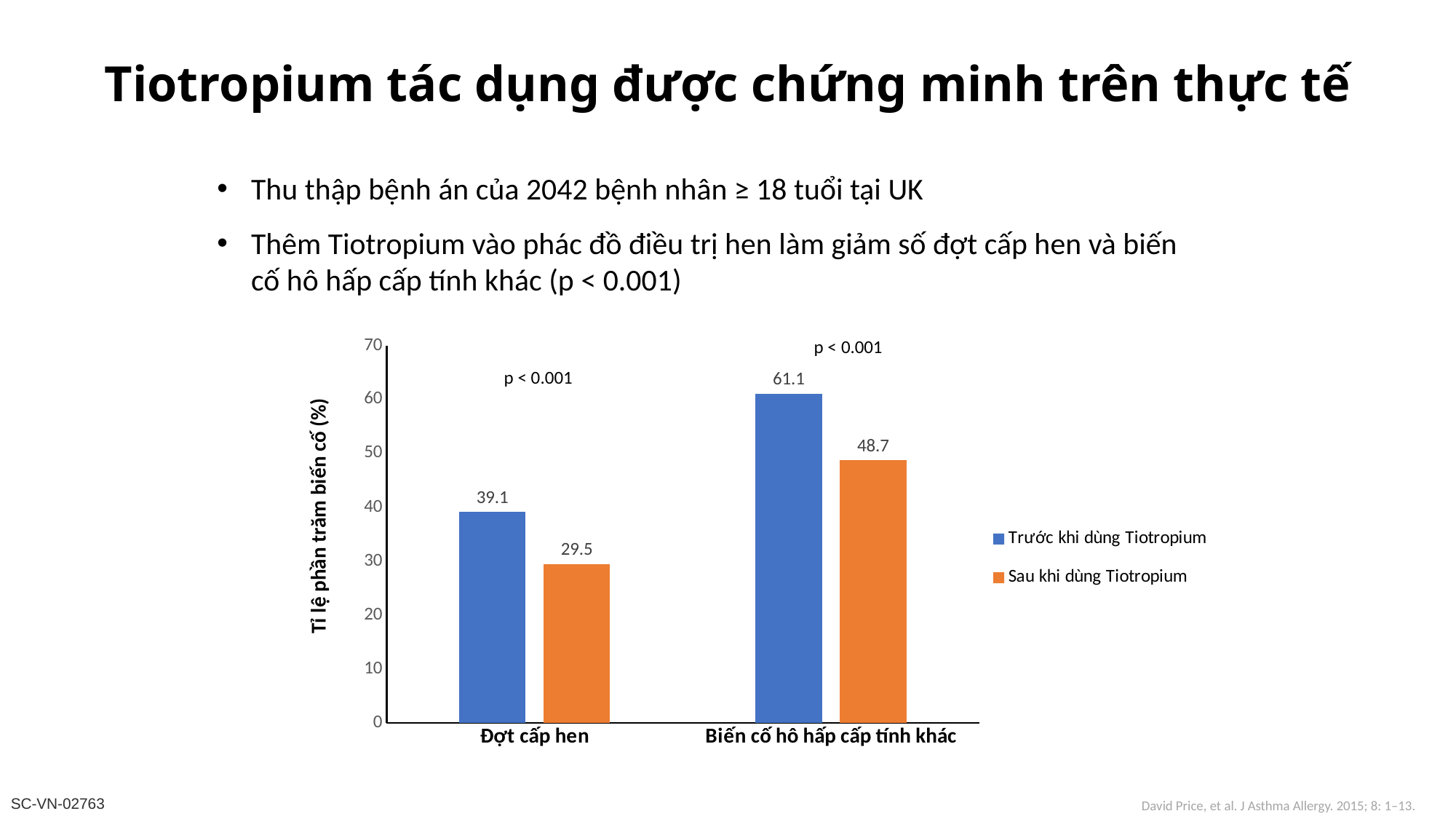
What is the value for 'Trước khi dùng Tiotropium' in the 'Đợt cấp hen' category? 39.1 How many series does the chart legend list? 2 What is the difference between the 'Trước khi dùng Tiotropium' and 'Sau khi dùng Tiotropium' values for 'Biến cố hô hấp cấp tính khác'? 12.4 Which bar has the lowest value on the chart? Sau khi dùng Tiotropium, Đợt cấp hen Which bar has the highest value on the chart? Trước khi dùng Tiotropium, Biến cố hô hấp cấp tính khác What is the value for 'Sau khi dùng Tiotropium' in the 'Biến cố hô hấp cấp tính khác' category? 48.7 What is the difference between the 'Trước khi dùng Tiotropium' and 'Sau khi dùng Tiotropium' values for 'Đợt cấp hen'? 9.6 What is the value for 'Trước khi dùng Tiotropium' in the 'Biến cố hô hấp cấp tính khác' category? 61.1 How many categories are shown on the x axis of the chart? 2 What kind of chart is shown on the slide? Bar chart Which is larger for 'Biến cố hô hấp cấp tính khác': the value before Tiotropium or after Tiotropium? Trước khi dùng Tiotropium What is the value for 'Sau khi dùng Tiotropium' in the 'Đợt cấp hen' category? 29.5